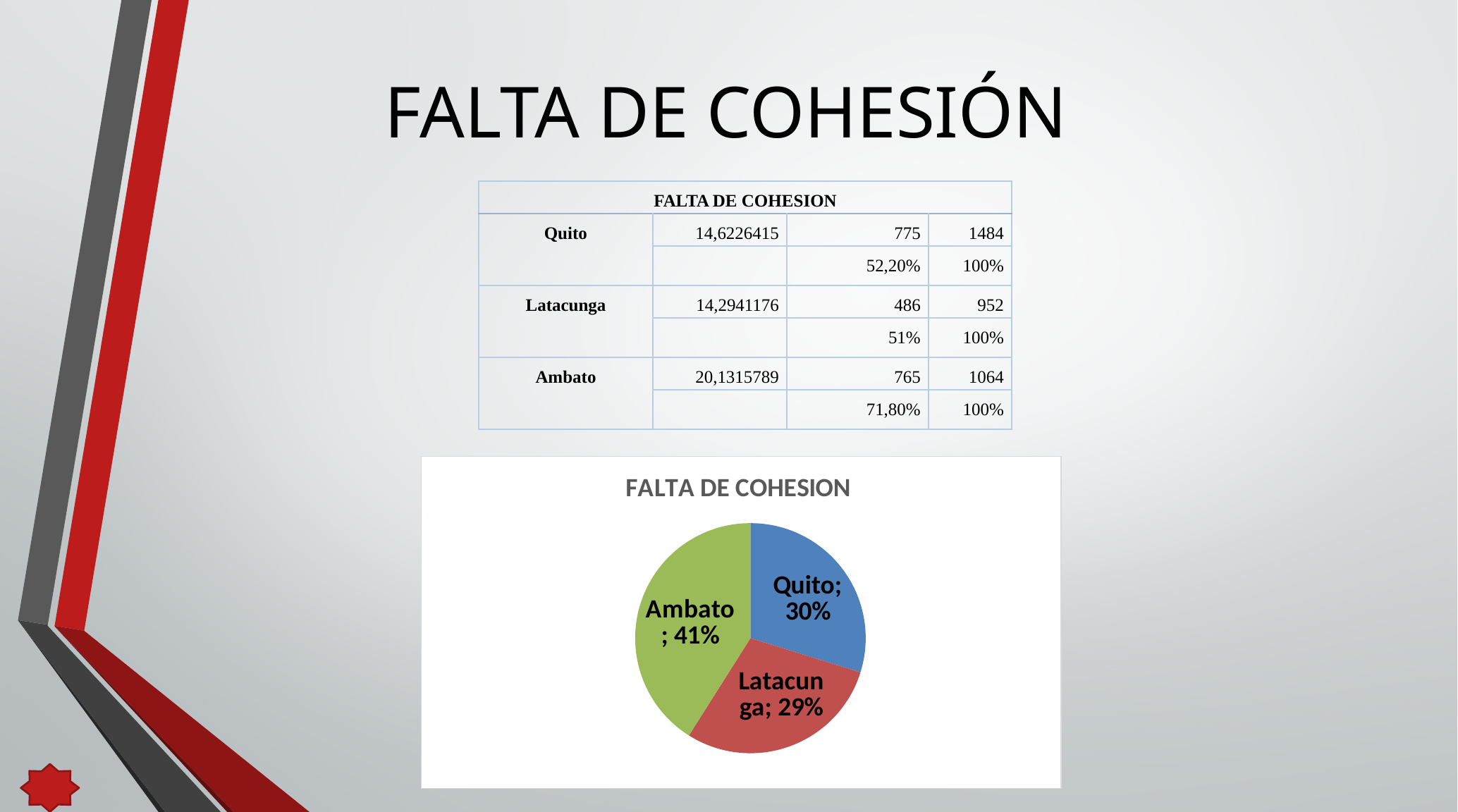
What share of the pie does Latacunga have? 29% What colour is the Ambato slice of the pie? green What is the difference in percentage points between Quito's share and Latacunga's share? 1 Which is larger, the share for Ambato or the share for Latacunga? Ambato What is the difference in percentage points between Ambato's share and Quito's share? 11 Which category has the largest slice of the pie? Ambato What share of the pie does Quito have? 30% What type of chart is shown on the slide? pie chart What is the title of the chart? FALTA DE COHESION How many slices does the pie chart have? 3 What share of the pie does Ambato have? 41%